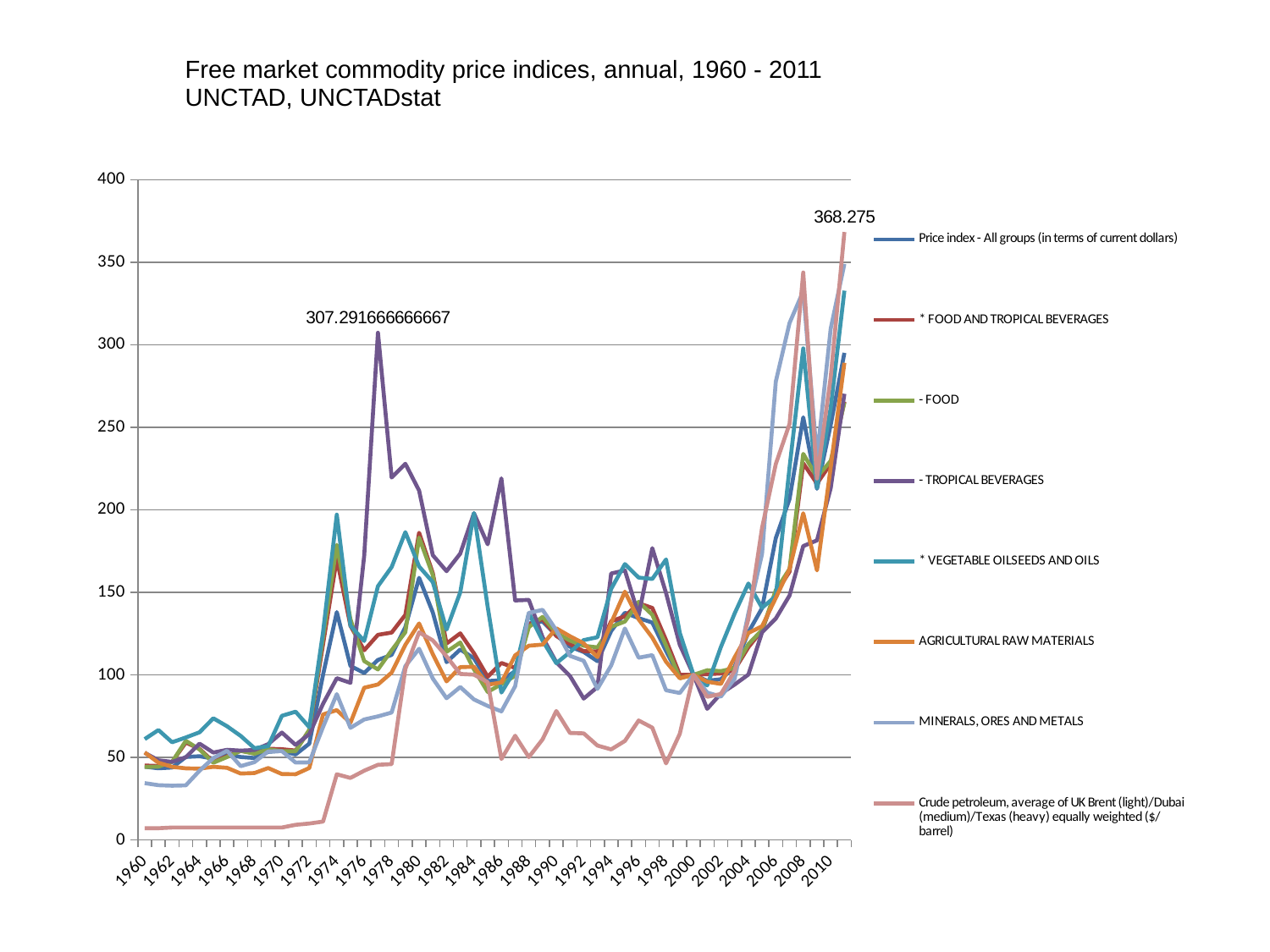
Is the value for Crude petroleum in 1960 greater or less than 50? less What is the value labeled at the 2011 peak of the Crude petroleum series? 368.275 What is the maximum value shown on the vertical axis? 400 Which series reaches the highest value shown on the chart? Crude petroleum, average of UK Brent (light)/Dubai (medium)/Texas (heavy) equally weighted ($/barrel) What is the value labeled at the 1977 peak of the Tropical Beverages series? 307.291666666667 Is the value for Vegetable Oilseeds and Oils in 1974 greater or less than 150? greater What is the title of the chart? Free market commodity price indices, annual, 1960 - 2011 UNCTAD, UNCTADstat Does the Crude petroleum series rise or fall between 2002 and 2008? rise What type of chart is shown on the slide? line chart What is the difference between the two labeled values, 368.275 and 307.291666666667? 60.983333333333 In 1977, which is higher: Tropical Beverages or Crude petroleum? Tropical Beverages How many series does the legend list? 8